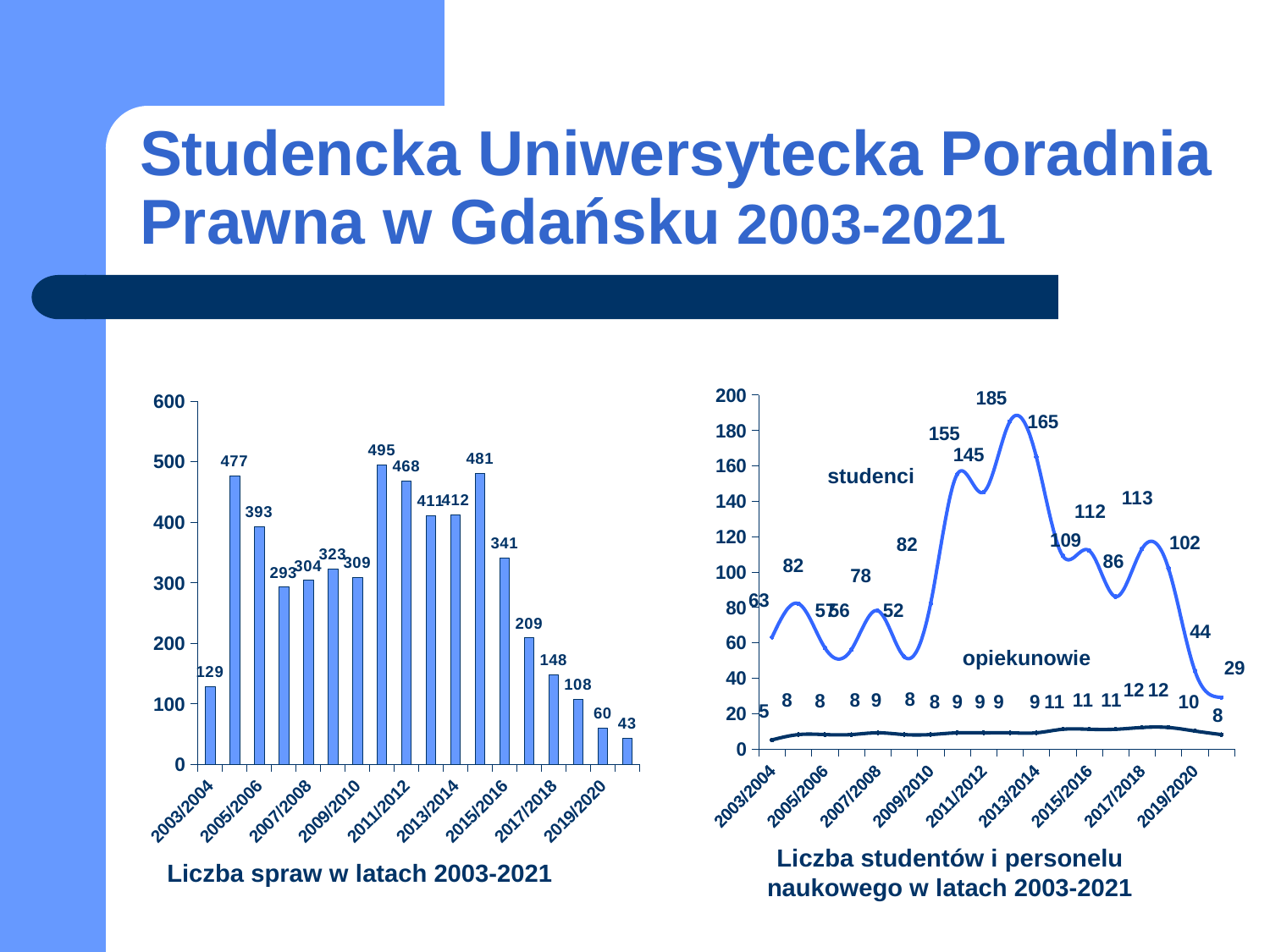
In the left chart 'Liczba spraw w latach 2003-2021', what is the value for 2003/2004? 129 How many bars are plotted in the left chart 'Liczba spraw w latach 2003-2021'? 18 In the left chart 'Liczba spraw w latach 2003-2021', what is the lowest value shown? 43 What kind of chart is the right chart, 'Liczba studentów i personelu naukowego w latach 2003-2021'? line chart In the right chart 'Liczba studentów i personelu naukowego w latach 2003-2021', what is the highest value of the 'studenci' series? 185 What kind of chart is the left chart, 'Liczba spraw w latach 2003-2021'? bar chart How many series are plotted in the right chart 'Liczba studentów i personelu naukowego w latach 2003-2021'? 2 In the right chart 'Liczba studentów i personelu naukowego w latach 2003-2021', what is the highest value of the 'opiekunowie' series? 12 In the left chart 'Liczba spraw w latach 2003-2021', what is the highest value shown? 495 In the right chart 'Liczba studentów i personelu naukowego w latach 2003-2021', which series has the larger value at 2003/2004, 'studenci' or 'opiekunowie'? studenci In the left chart 'Liczba spraw w latach 2003-2021', what is the difference between the highest value (495) and the lowest value (43)? 452 In the left chart 'Liczba spraw w latach 2003-2021', what is the value for 2019/2020? 60